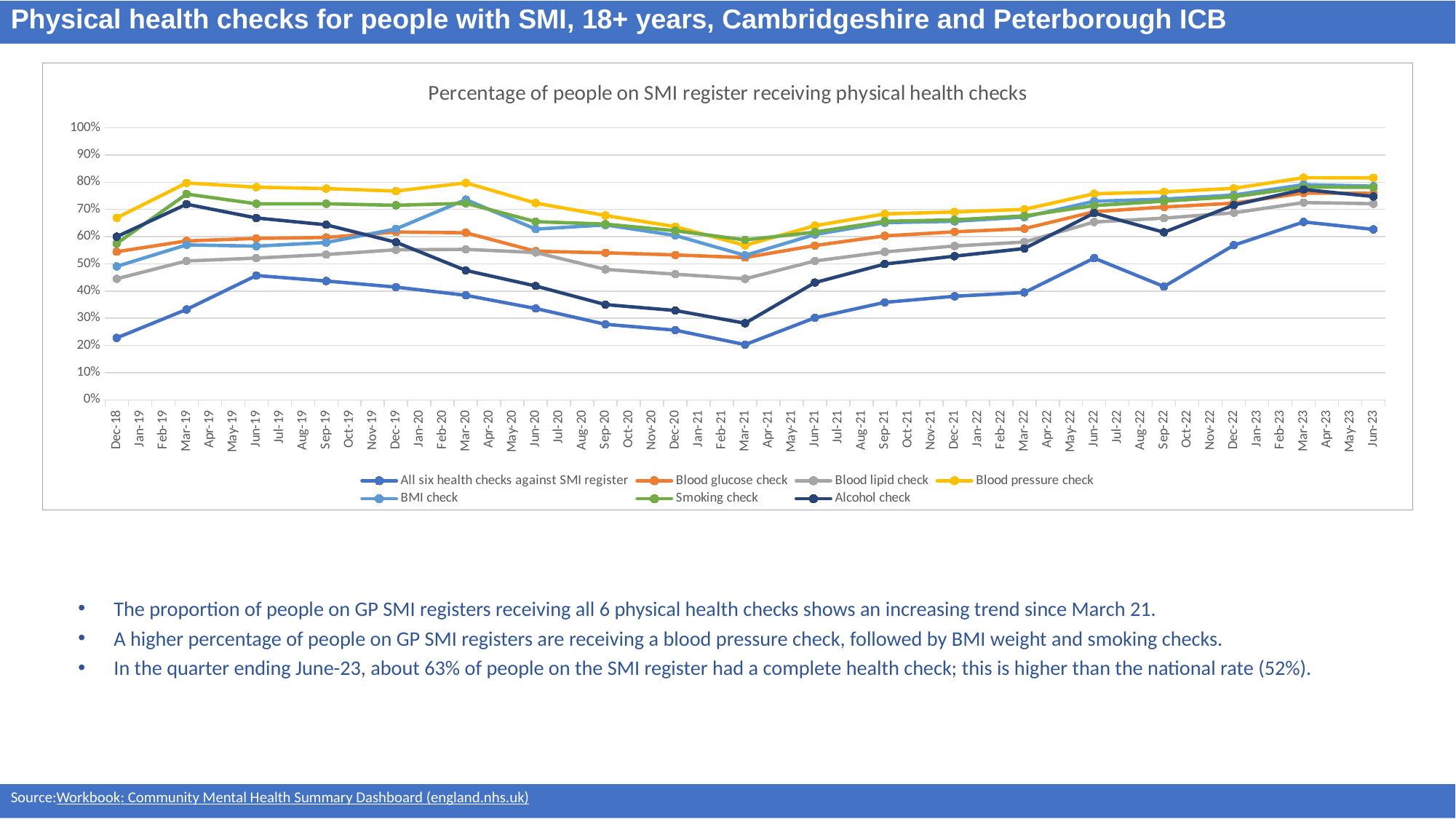
Is the value for 'Alcohol check' at Mar-21 greater or less than 40%? less Is the value for 'All six health checks against SMI register' at Mar-21 greater or less than 30%? less Which series has the highest values across most of the period? Blood pressure check How many series does the legend list? 7 Which series is plotted in yellow? Blood pressure check What is the title of the chart? Percentage of people on SMI register receiving physical health checks Which is larger for 'All six health checks against SMI register': the value at Dec-18 or the value at Jun-23? Jun-23 Is the value for 'Blood pressure check' at Mar-19 greater or less than 70%? greater At which date does the 'All six health checks against SMI register' series reach its lowest point? Mar-21 What kind of chart is shown on the slide? Line chart From Mar-21 to Jun-23, does the 'All six health checks against SMI register' series generally rise or fall? Rise Which series has the lowest values across the whole period? All six health checks against SMI register